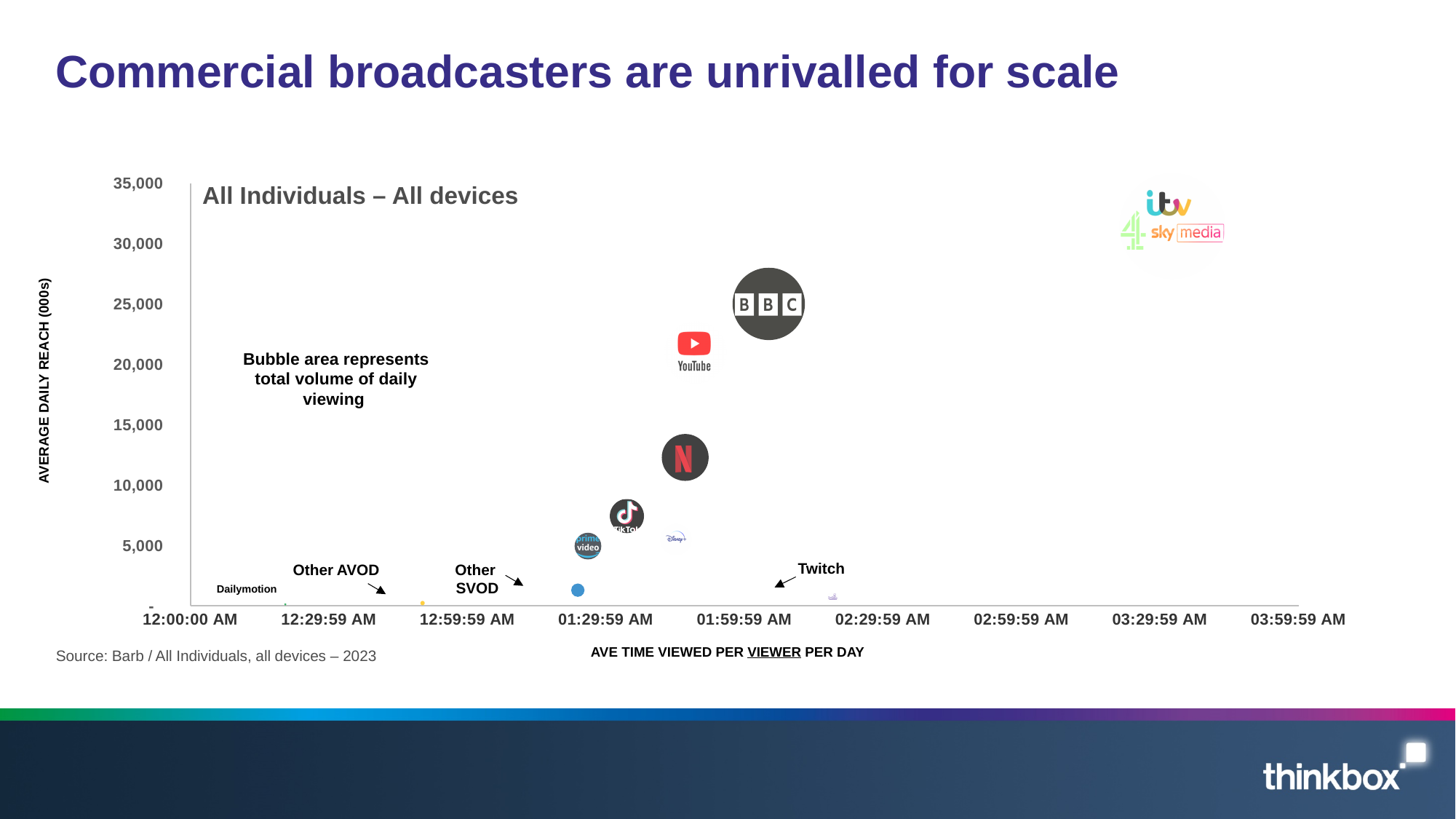
Is the average daily reach for Netflix greater or less than 15,000? less Is the average daily reach for TikTok greater or less than 10,000? less What does the vertical axis of the chart measure? Average daily reach (000s) Which has a longer average time viewed per viewer per day, Twitch or Dailymotion? Twitch Is the average daily reach for Twitch greater or less than 5,000? less Which has a higher average daily reach, YouTube or TikTok? YouTube What kind of chart is shown on the slide? Bubble chart Which platform has the highest average daily reach on the chart? ITV / Channel 4 / Sky Media (commercial broadcasters) Which has a higher average daily reach, BBC or Netflix? BBC What does the horizontal axis of the chart measure? Ave time viewed per viewer per day